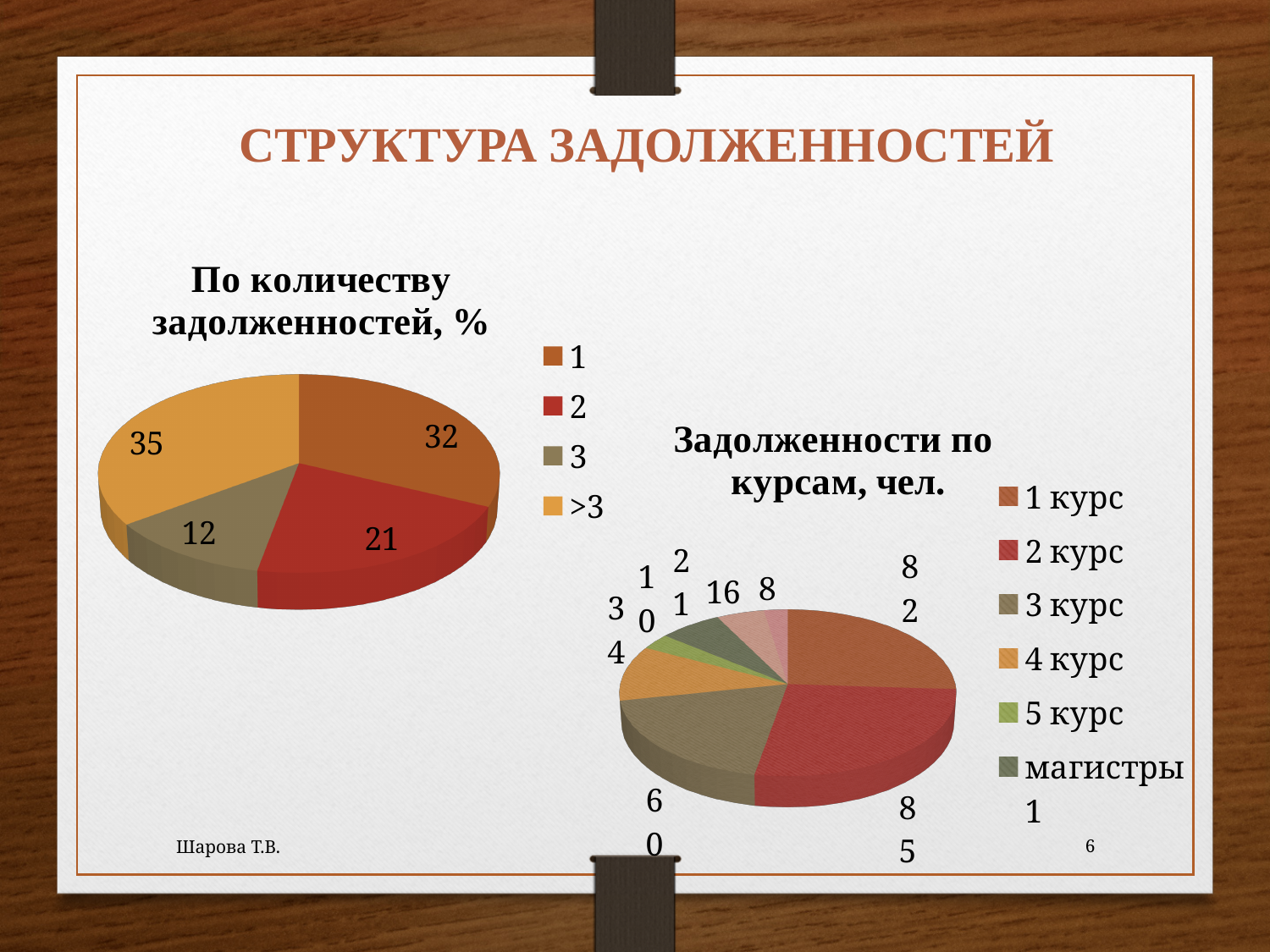
How many categories does the chart titled "По количеству задолженностей, %" show? 4 In the chart titled "Задолженности по курсам, чел.", what is the value for "3 курс"? 60 In the chart titled "По количеству задолженностей, %", what is the value for category "1"? 32 In the chart titled "По количеству задолженностей, %", what is the value for category ">3"? 35 In the chart titled "По количеству задолженностей, %", which category has the smallest slice? 3 In the chart titled "По количеству задолженностей, %", what is the value for category "3"? 12 What kind of chart is the chart titled "Задолженности по курсам, чел."? pie chart In the chart titled "По количеству задолженностей, %", which is larger, the value for "2" or the value for "3"? 2 In the chart titled "По количеству задолженностей, %", which category has the largest slice? >3 In the chart titled "Задолженности по курсам, чел.", what is the value for "2 курс"? 85 In the chart titled "Задолженности по курсам, чел.", which is larger, the value for "1 курс" or the value for "3 курс"? 1 курс In the chart titled "По количеству задолженностей, %", what is the difference between the values for ">3" and "1"? 3